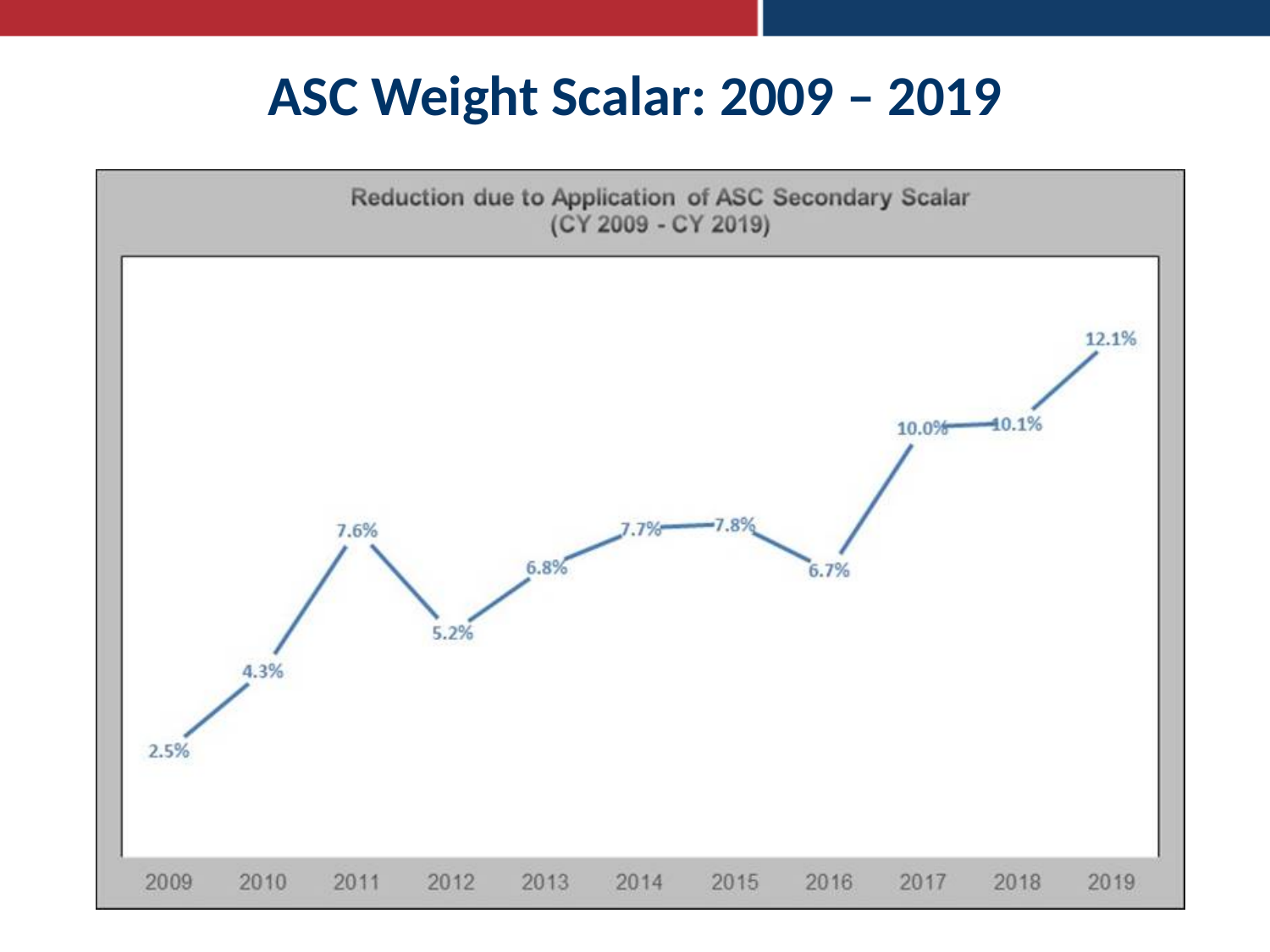
What is the difference between the values for 2011 and 2012? 2.4% What is the value for 2016? 6.7% What is the value for 2009? 2.5% What is the difference between the values for 2019 and 2009? 9.6% What is the value for 2019? 12.1% What kind of chart is shown? line chart Which is larger, the value for 2011 or the value for 2016? 2011 Which year has the lowest value? 2009 What is the title of the chart? Reduction due to Application of ASC Secondary Scalar (CY 2009 - CY 2019) How many years are plotted on the chart? 11 What is the value for 2012? 5.2% Which year has the highest value? 2019